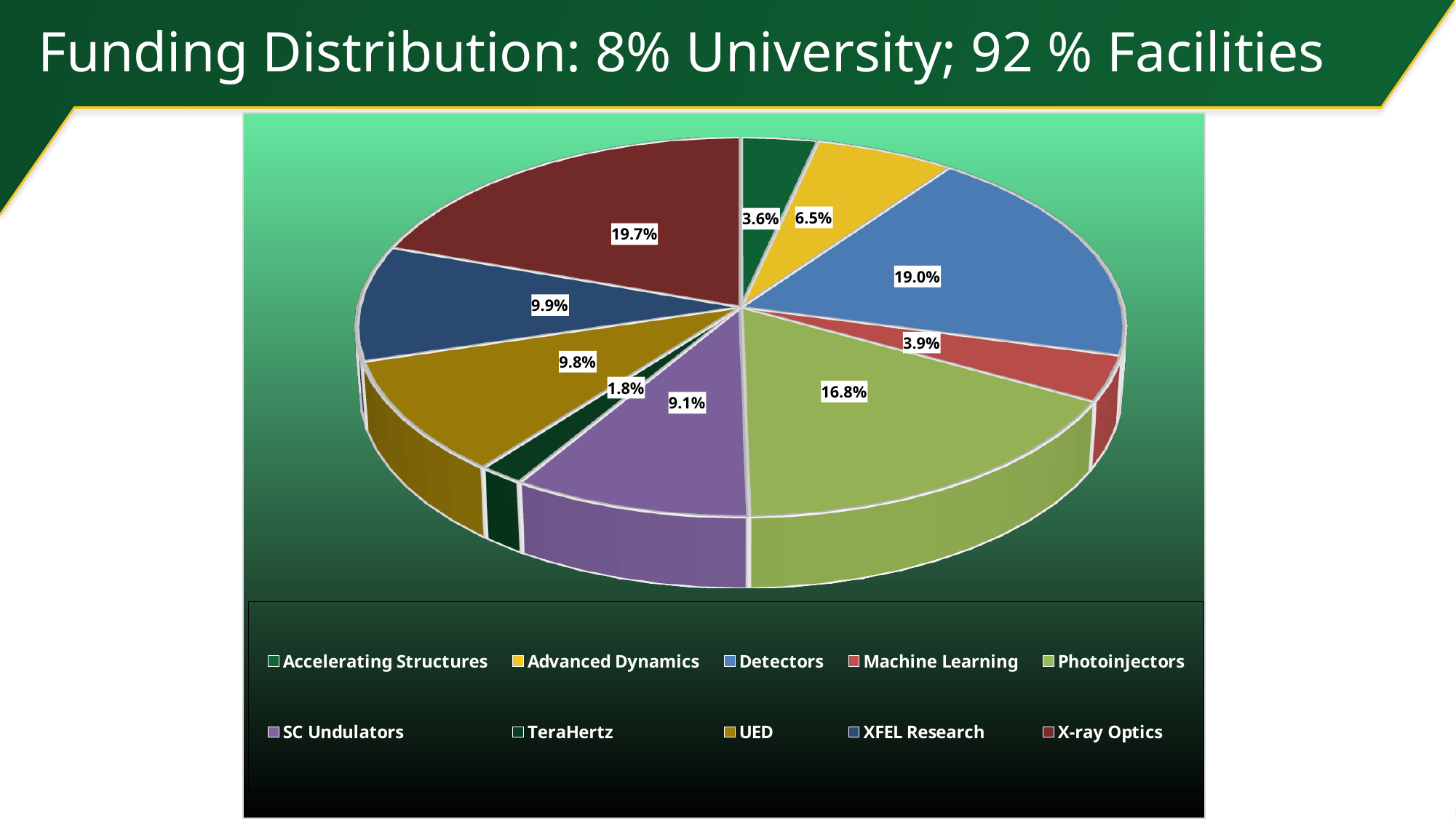
Which is larger, the share for Advanced Dynamics or the share for Machine Learning? Advanced Dynamics Which category has the smallest slice of the pie? TeraHertz What colour is the Machine Learning slice? red How many categories does the pie chart show? 10 What kind of chart is shown on the slide? pie chart What share of funding goes to SC Undulators? 9.1% What share of funding goes to TeraHertz? 1.8% What share of funding goes to Photoinjectors? 16.8% What share of funding goes to Detectors? 19.0% Which category has the largest slice of the pie? X-ray Optics What is the combined share of UED and XFEL Research? 19.7% What is the difference between the shares for X-ray Optics and Detectors? 0.7%